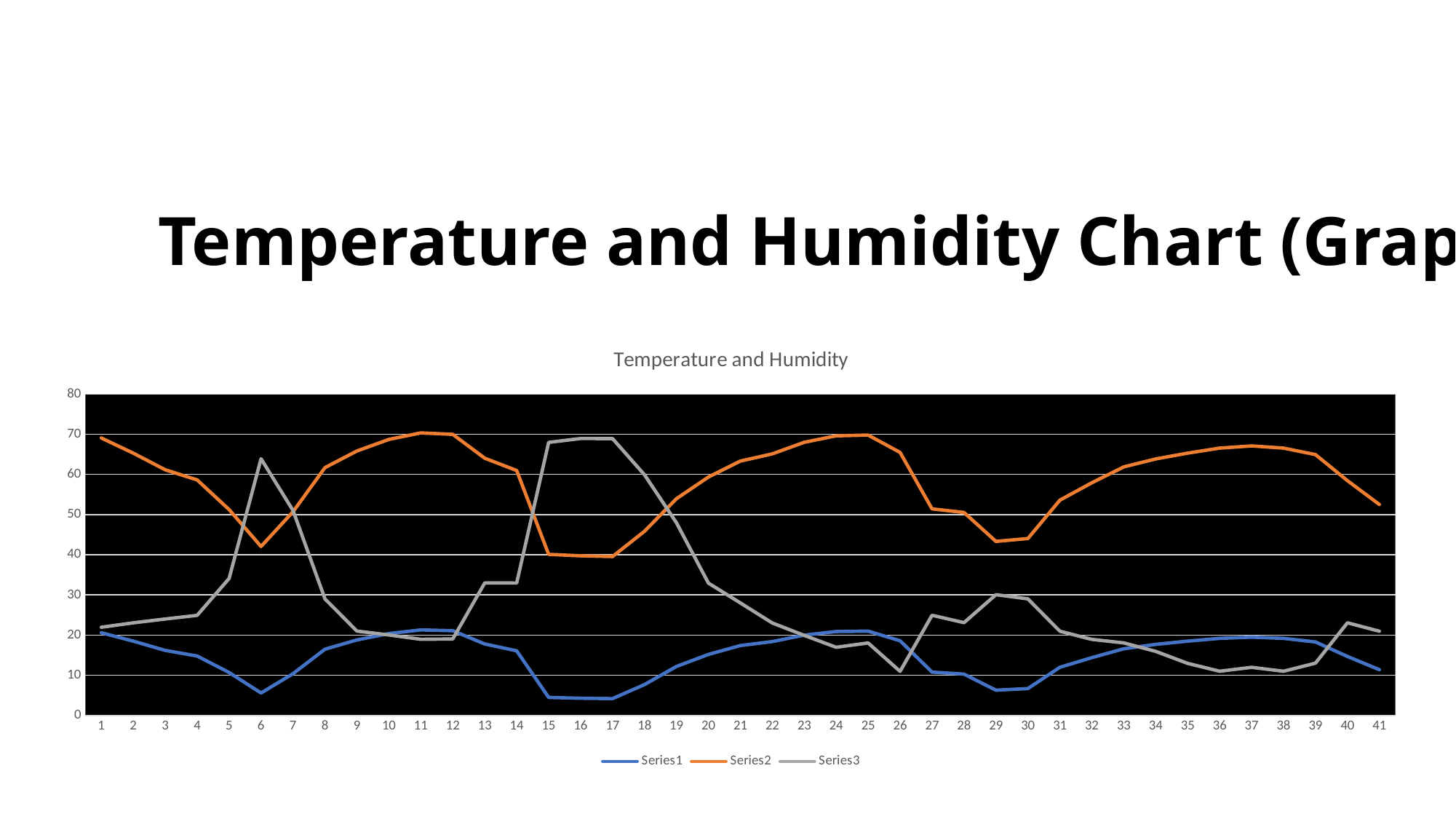
Is the value for Series2 at point 1 greater or less than 60? greater How many points are on the x axis of the chart? 41 What is the title of the chart? Temperature and Humidity At point 29, which series has the highest value? Series2 How many series does the legend list? 3 Is the value for Series3 at point 16 greater or less than 60? greater Is the value for Series1 at point 6 greater or less than 10? less What kind of chart is shown on the slide? line chart At point 16, which is larger: Series3 or Series2? Series3 Which colour is used for Series2 in the chart? orange Does Series2 rise or fall from point 1 to point 6? fall